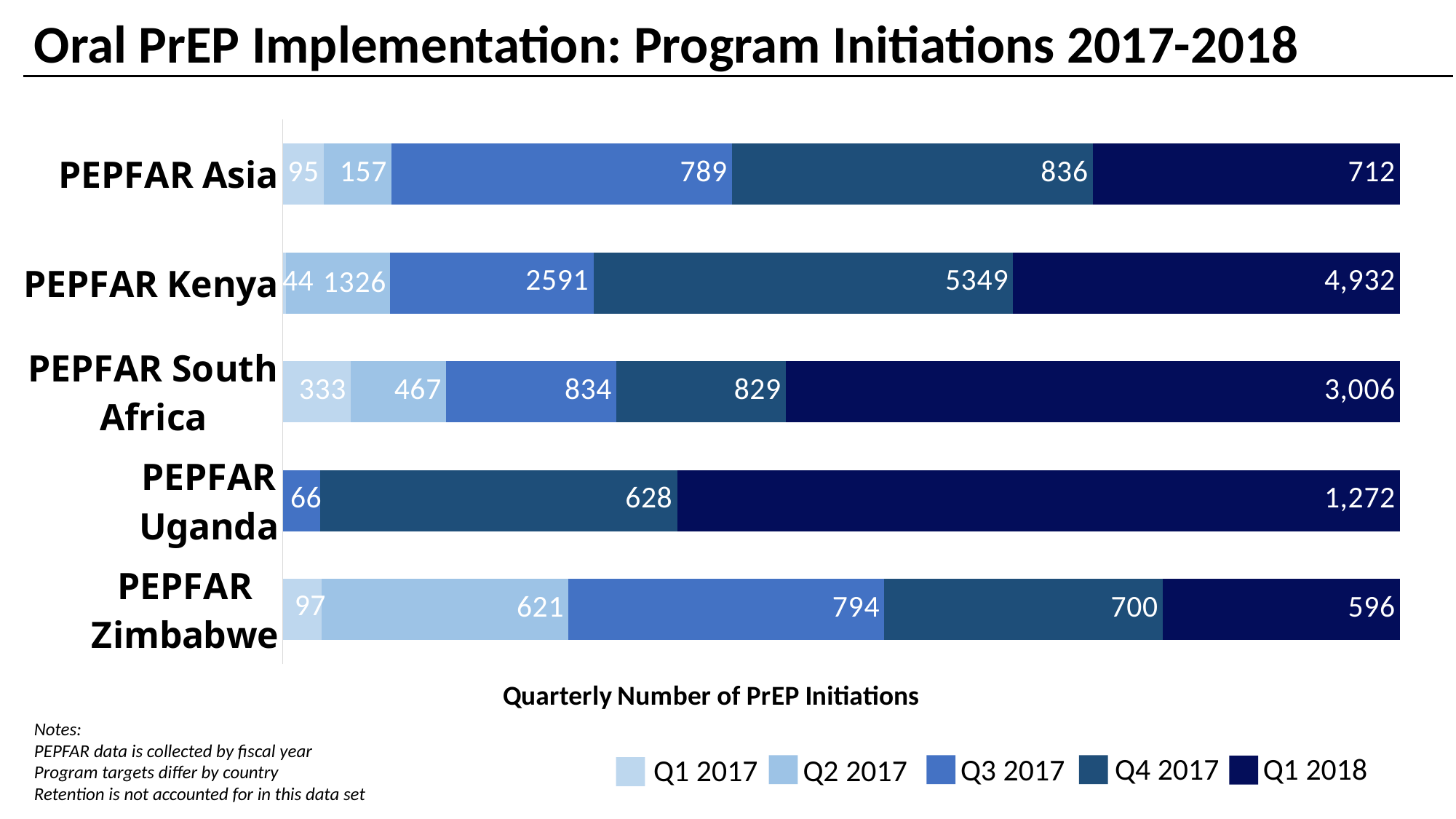
How many series does the legend list? 5 What is the difference between the Q4 2017 and Q3 2017 values for PEPFAR Kenya? 2758 What is the total of the PEPFAR Uganda bar? 1,966 Which country has the highest Q1 2018 value? PEPFAR Kenya What kind of chart is shown on the slide? Stacked bar chart Which country has the lowest Q1 2018 value? PEPFAR Zimbabwe What is the Q4 2017 value for PEPFAR Kenya? 5349 What is the Q2 2017 value for PEPFAR Zimbabwe? 621 How many countries/regions are shown on the chart? 5 What is the Q3 2017 value for PEPFAR Uganda? 66 What is the Q1 2018 value for PEPFAR South Africa? 3,006 Which is larger for PEPFAR Asia: the Q3 2017 value or the Q1 2018 value? Q3 2017